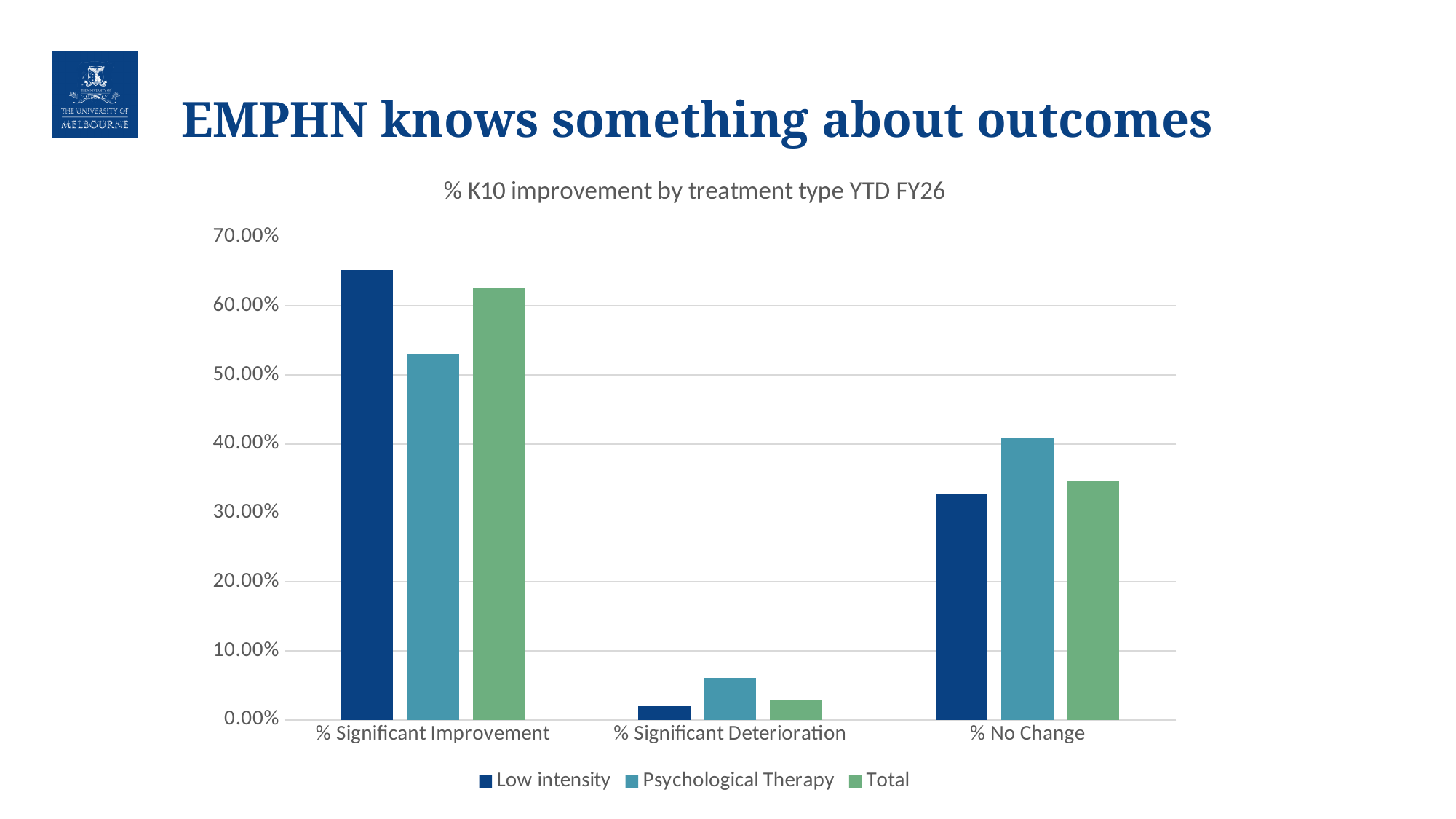
Is the Psychological Therapy value for % Significant Deterioration greater or less than 10.00%? less Which series has the lowest value for % Significant Improvement? Psychological Therapy What kind of chart is shown on the slide? Bar chart Which series has the highest value for % Significant Improvement? Low intensity For % No Change, which is larger: the Low intensity value or the Psychological Therapy value? Psychological Therapy Which series has the highest value for % No Change? Psychological Therapy How many series does the legend list? 3 How many categories are shown on the x axis? 3 Is the Low intensity value for % Significant Improvement greater or less than 60.00%? greater Which series has the lowest value for % Significant Deterioration? Low intensity What is the title of the chart? % K10 improvement by treatment type YTD FY26